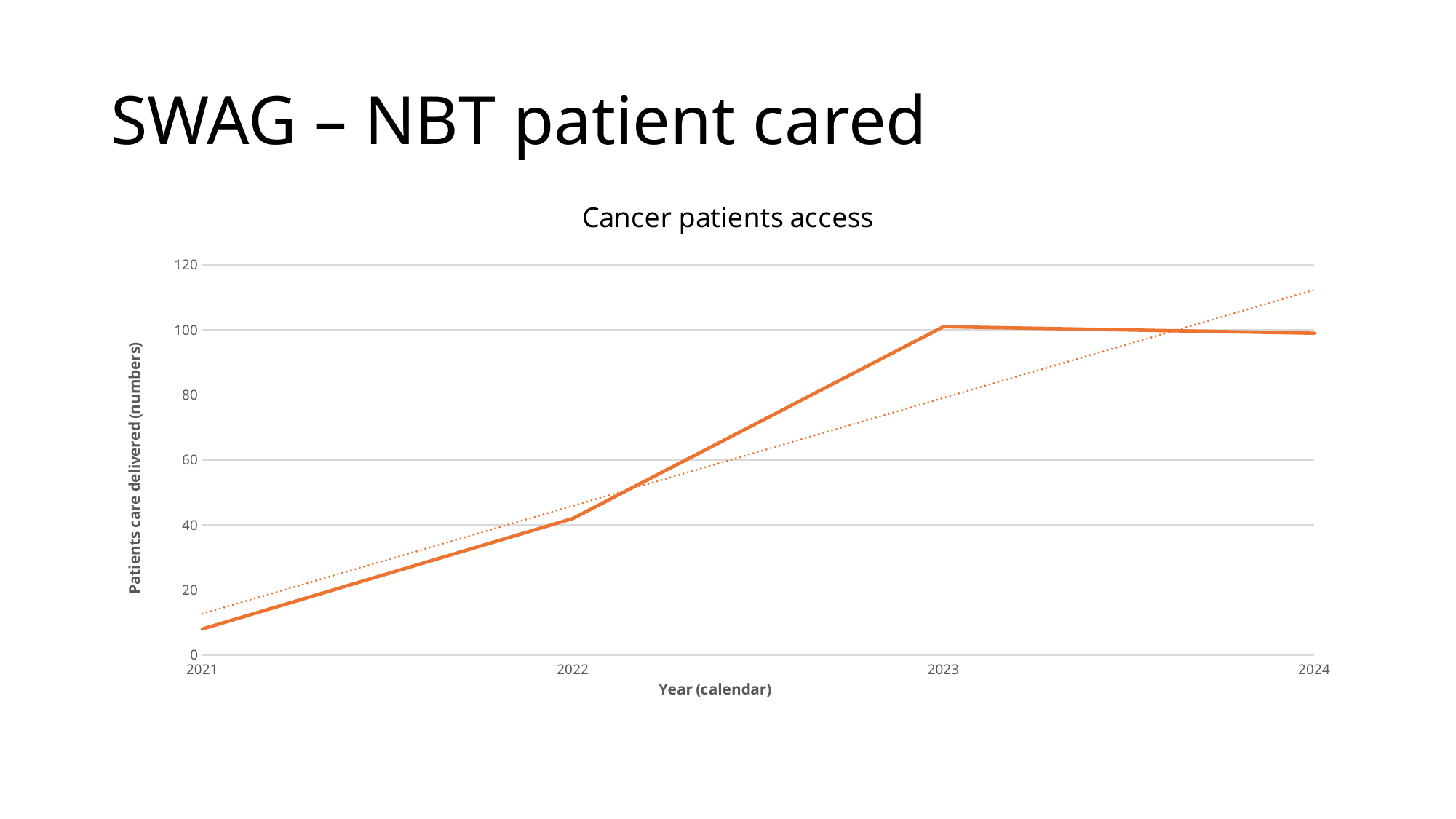
Which year has the larger value, 2021 or 2022? 2022 What kind of chart is shown on the slide? line chart What is the label on the vertical axis of the chart? Patients care delivered (numbers) Do the values rise or fall from 2021 to 2023? rise Is the value for 2021 greater or less than 20? less Which year has the larger value, 2022 or 2023? 2023 Is the value for 2022 greater or less than 60? less Is the value for 2023 greater or less than 80? greater Which year has the lowest value on the chart? 2021 What is the title of the chart? Cancer patients access How many years are plotted on the x axis of the chart? 4